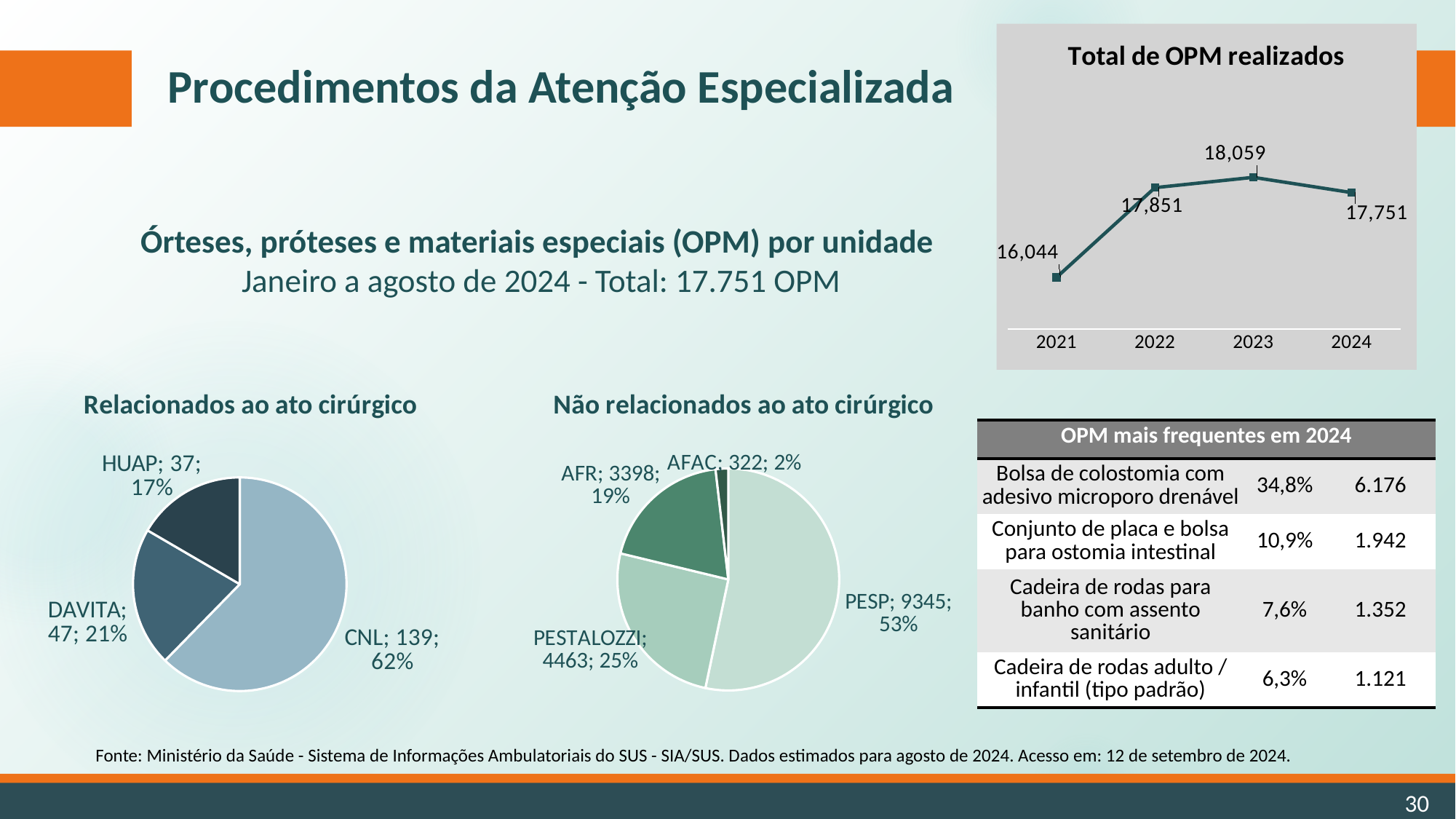
In the 'Total de OPM realizados' chart, what is the difference between the 2023 and 2024 values? 308 What kind of chart is 'Total de OPM realizados'? Line chart In the 'Relacionados ao ato cirúrgico' pie chart, what is the value for DAVITA? 47 In the 'Não relacionados ao ato cirúrgico' pie chart, which unit has the smallest slice? AFAC In the 'Relacionados ao ato cirúrgico' pie chart, which unit has the largest slice? CNL In the 'Não relacionados ao ato cirúrgico' pie chart, what is the value for PESTALOZZI? 4463 In the 'Total de OPM realizados' chart, which year has the highest value? 2023 In the 'Total de OPM realizados' chart, what is the value for 2021? 16,044 In the 'Relacionados ao ato cirúrgico' pie chart, what share does HUAP represent? 17% In the 'Total de OPM realizados' chart, how many years are plotted? 4 In the 'Total de OPM realizados' chart, which year has the lowest value? 2021 In the 'Não relacionados ao ato cirúrgico' pie chart, which is larger, AFR or PESTALOZZI? PESTALOZZI